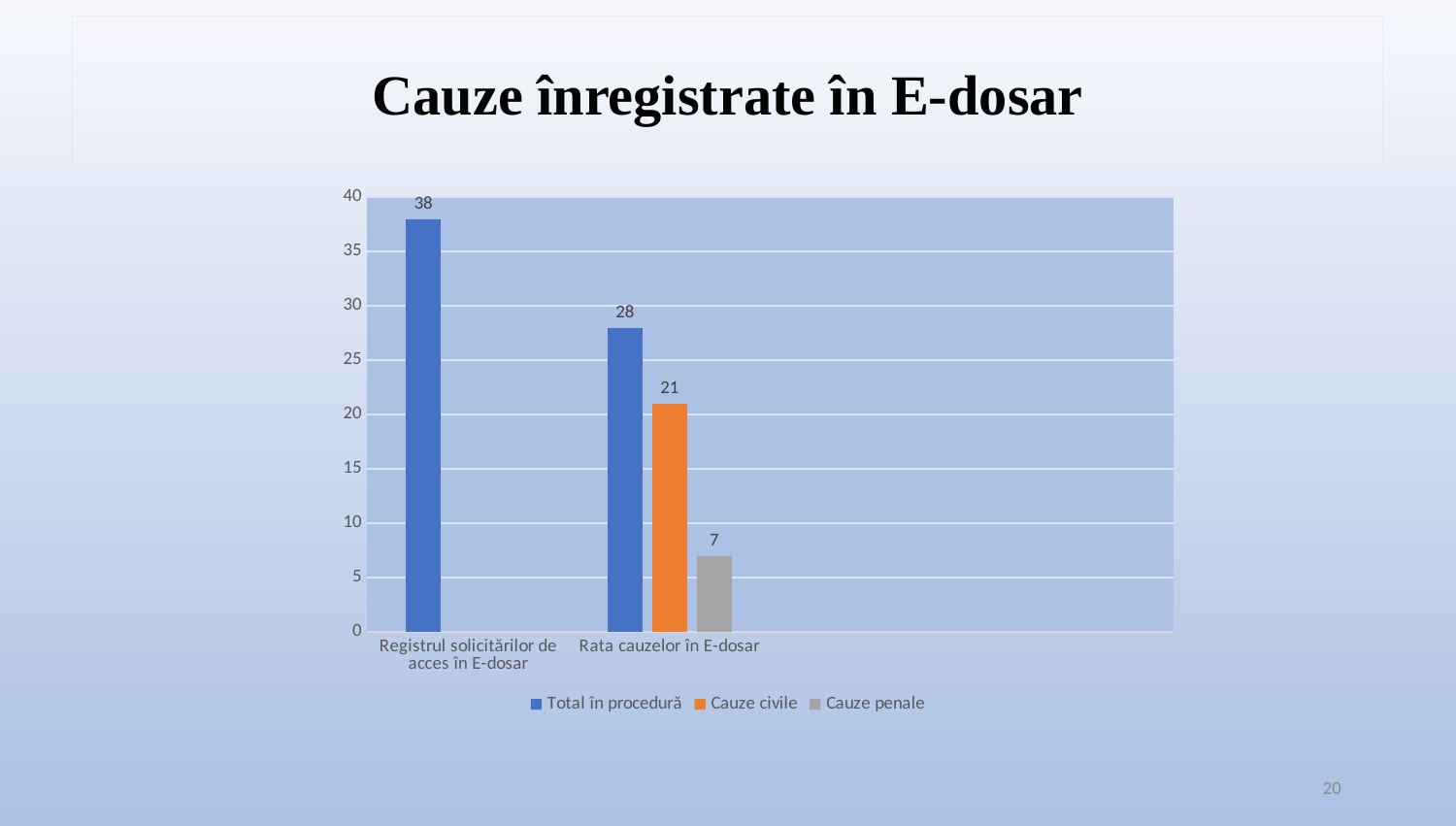
What is the title of the slide? Cauze înregistrate în E-dosar Which series has the lowest value for "Rata cauzelor în E-dosar"? Cauze penale What is the difference between the "Total în procedură" values of the two categories? 10 What is the value of "Total în procedură" for "Registrul solicitărilor de acces în E-dosar"? 38 What is the value of "Cauze civile" for "Rata cauzelor în E-dosar"? 21 How many series does the legend list? 3 What is the value of "Total în procedură" for "Rata cauzelor în E-dosar"? 28 What is the difference between "Cauze civile" and "Cauze penale" for "Rata cauzelor în E-dosar"? 14 Which is larger for "Rata cauzelor în E-dosar": "Cauze civile" or "Cauze penale"? Cauze civile What kind of chart is shown on the slide? Bar chart What is the value of "Cauze penale" for "Rata cauzelor în E-dosar"? 7 Which category has the highest "Total în procedură" value? Registrul solicitărilor de acces în E-dosar